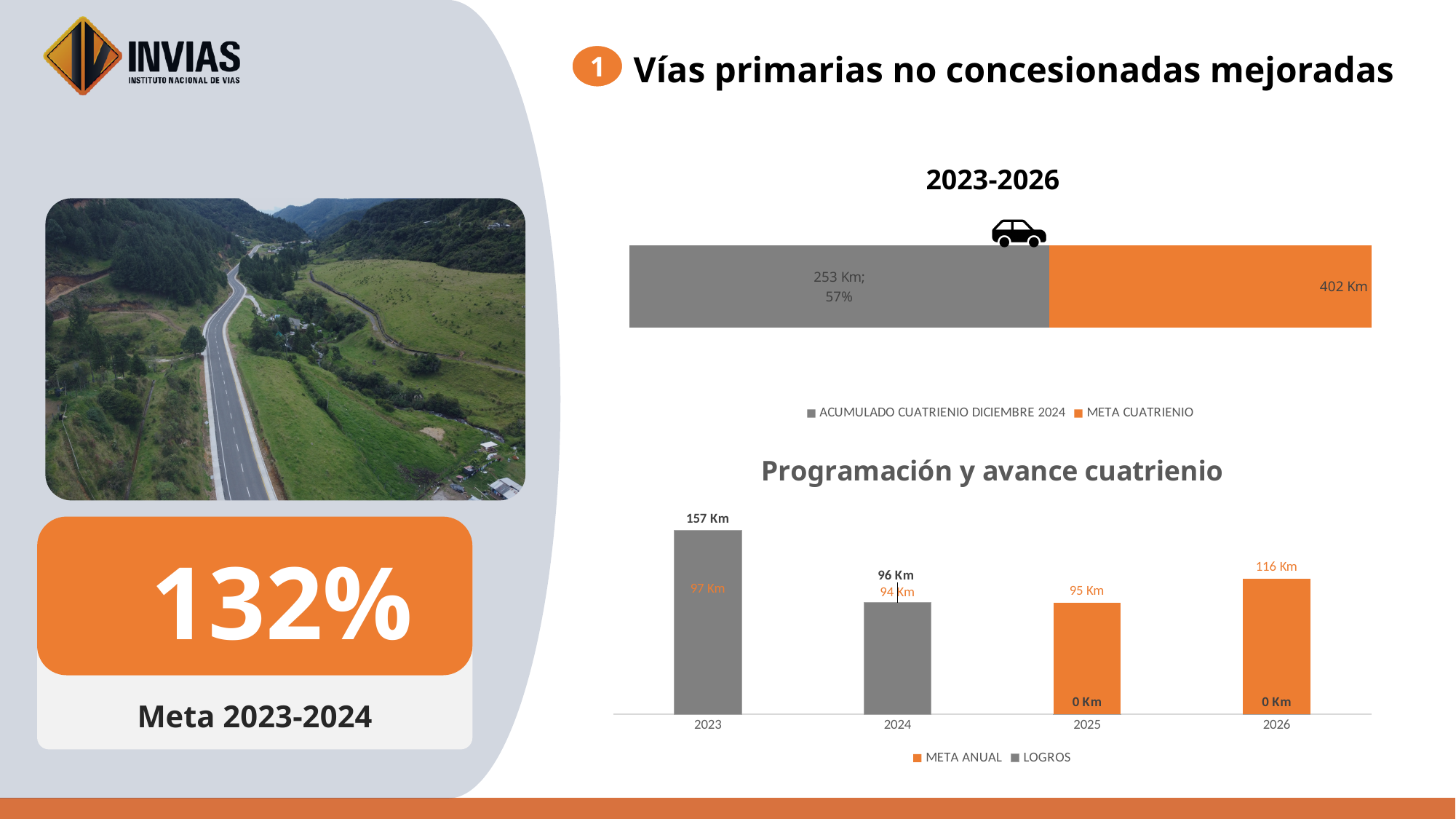
In the 'Programación y avance cuatrienio' chart, which year has the highest META ANUAL value? 2026 In the 'Programación y avance cuatrienio' chart, what is the difference between the LOGROS value and the META ANUAL value for 2023? 60 Km In the '2023-2026' chart, how many series does the legend list? 2 In the 'Programación y avance cuatrienio' chart, what is the META ANUAL value for 2026? 116 Km In the 'Programación y avance cuatrienio' chart, which year has the highest LOGROS value? 2023 In the '2023-2026' chart, what value is shown for ACUMULADO CUATRIENIO DICIEMBRE 2024? 253 Km What kind of chart is 'Programación y avance cuatrienio'? Bar chart In the 'Programación y avance cuatrienio' chart, how many years are shown on the x axis? 4 In the 'Programación y avance cuatrienio' chart, what is the LOGROS value for 2023? 157 Km In the '2023-2026' chart, what value is shown for META CUATRIENIO? 402 Km In the 'Programación y avance cuatrienio' chart, what is the META ANUAL value for 2024? 94 Km In the '2023-2026' chart, what percentage is printed on the ACUMULADO CUATRIENIO DICIEMBRE 2024 bar? 57%